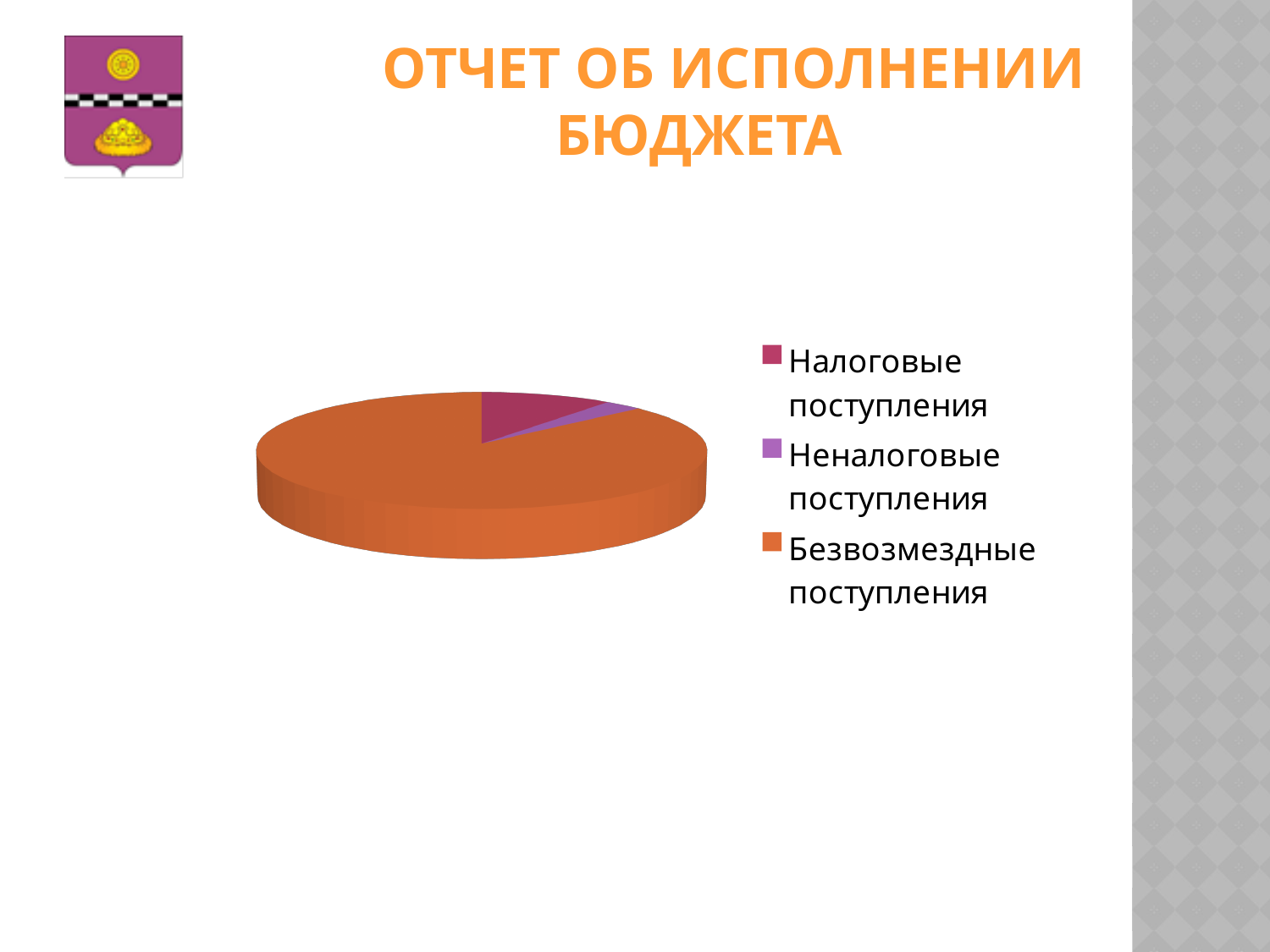
Which category has the smallest slice in the pie chart? Неналоговые поступления What colour is the slice for Безвозмездные поступления? Orange How many entries does the legend of the pie chart list? 3 Which slice is larger: Налоговые поступления or Неналоговые поступления? Налоговые поступления What is the title of the slide containing the pie chart? ОТЧЕТ ОБ ИСПОЛНЕНИИ БЮДЖЕТА Which slice is larger: Безвозмездные поступления or Налоговые поступления? Безвозмездные поступления Which category has the largest slice in the pie chart? Безвозмездные поступления What kind of chart is shown on the slide? Pie chart How many categories does the pie chart show? 3